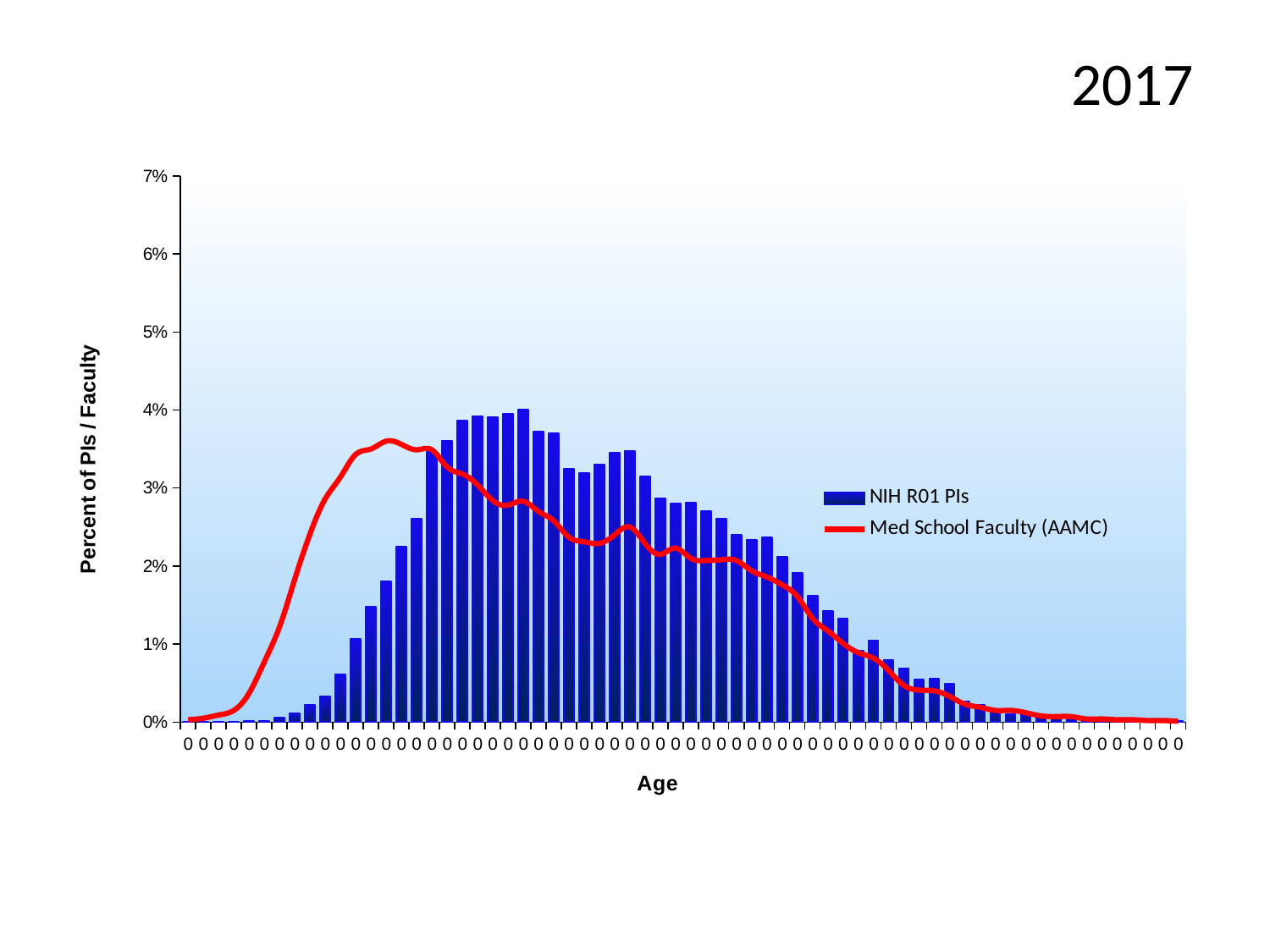
What kind of chart is this? A bar chart with an overlaid line Is the peak of the Med School Faculty (AAMC) line greater or less than 3%? greater Which series reaches a higher peak value, NIH R01 PIs or Med School Faculty (AAMC)? NIH R01 PIs Is the peak of the Med School Faculty (AAMC) line greater or less than 4%? less How many series does the legend list? 2 What is the title of the vertical axis? Percent of PIs / Faculty Toward the right end of the x axis, do the NIH R01 PIs bars rise or fall? fall Which series is drawn as the red line? Med School Faculty (AAMC) What is the highest value shown on the vertical axis? 7%